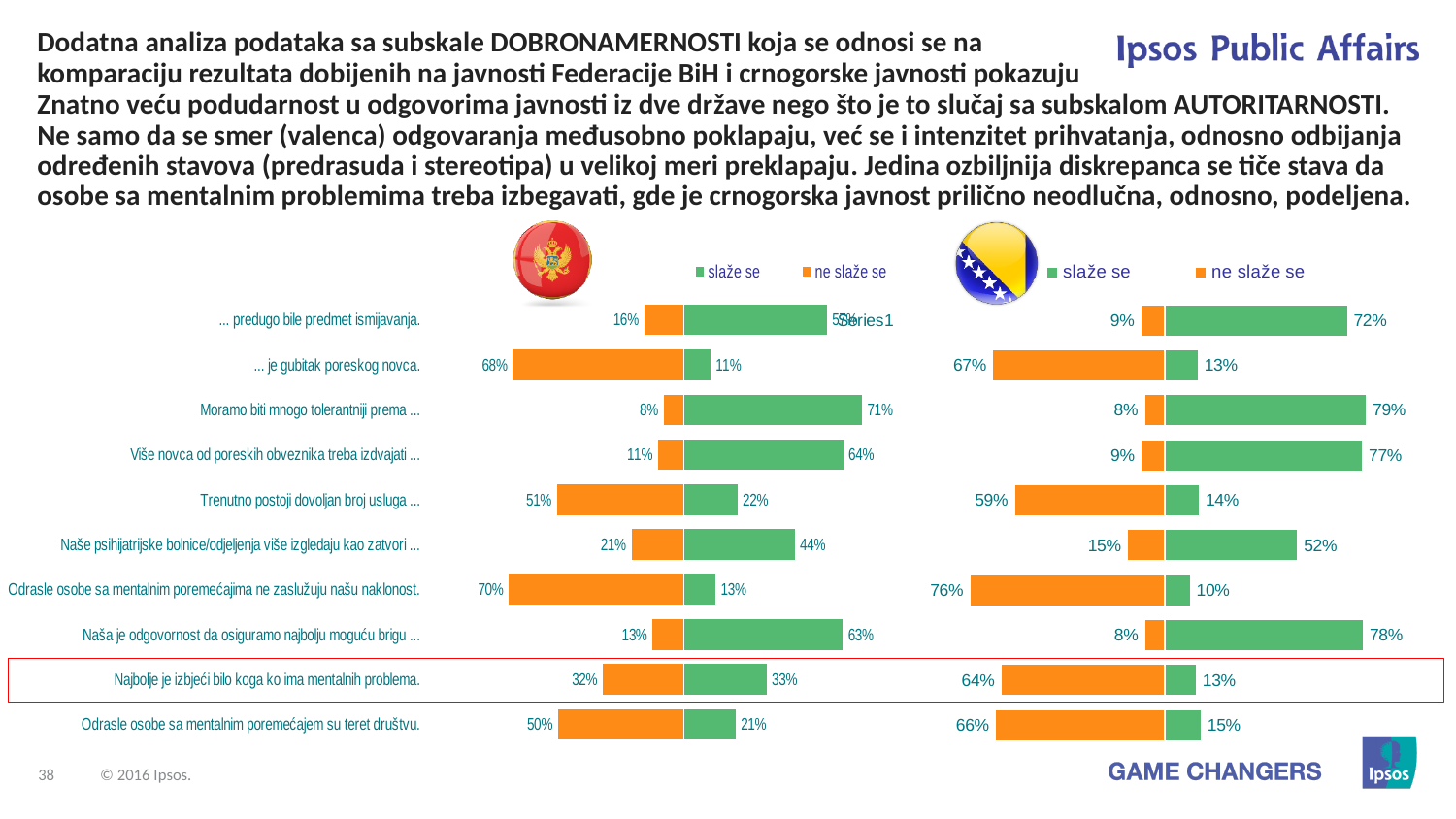
In the right chart (Bosnia and Herzegovina flag), what is the 'slaže se' value for 'Naša je odgovornost da osiguramo najbolju moguću brigu ...'? 78% What is the difference between the 'ne slaže se' values for 'Najbolje je izbjeći bilo koga ko ima mentalnih problema.' in the right chart (64%) and the left chart (32%)? 32 percentage points What type of chart is used on this slide? Bar chart How many statements (categories) are listed in each chart? 10 In the right chart (Bosnia and Herzegovina flag), which statement has the highest 'slaže se' value? Moramo biti mnogo tolerantniji prema ... In the right chart (Bosnia and Herzegovina flag), what percentage 'ne slaže se' with 'Odrasle osobe sa mentalnim poremećajima ne zaslužuju našu naklonost.'? 76% In the left chart (Montenegro flag), what is the 'ne slaže se' value for 'Najbolje je izbjeći bilo koga ko ima mentalnih problema.'? 32% Which colour represents 'ne slaže se' in the charts? Orange In the left chart (Montenegro flag), which is larger for 'Trenutno postoji dovoljan broj usluga ...': 'slaže se' or 'ne slaže se'? ne slaže se In the left chart (Montenegro flag), what percentage 'slaže se' with 'Moramo biti mnogo tolerantniji prema ...'? 71% How many series does the legend of the right chart list? 2 In the left chart (Montenegro flag), which statement has the lowest 'ne slaže se' value? Moramo biti mnogo tolerantniji prema ...